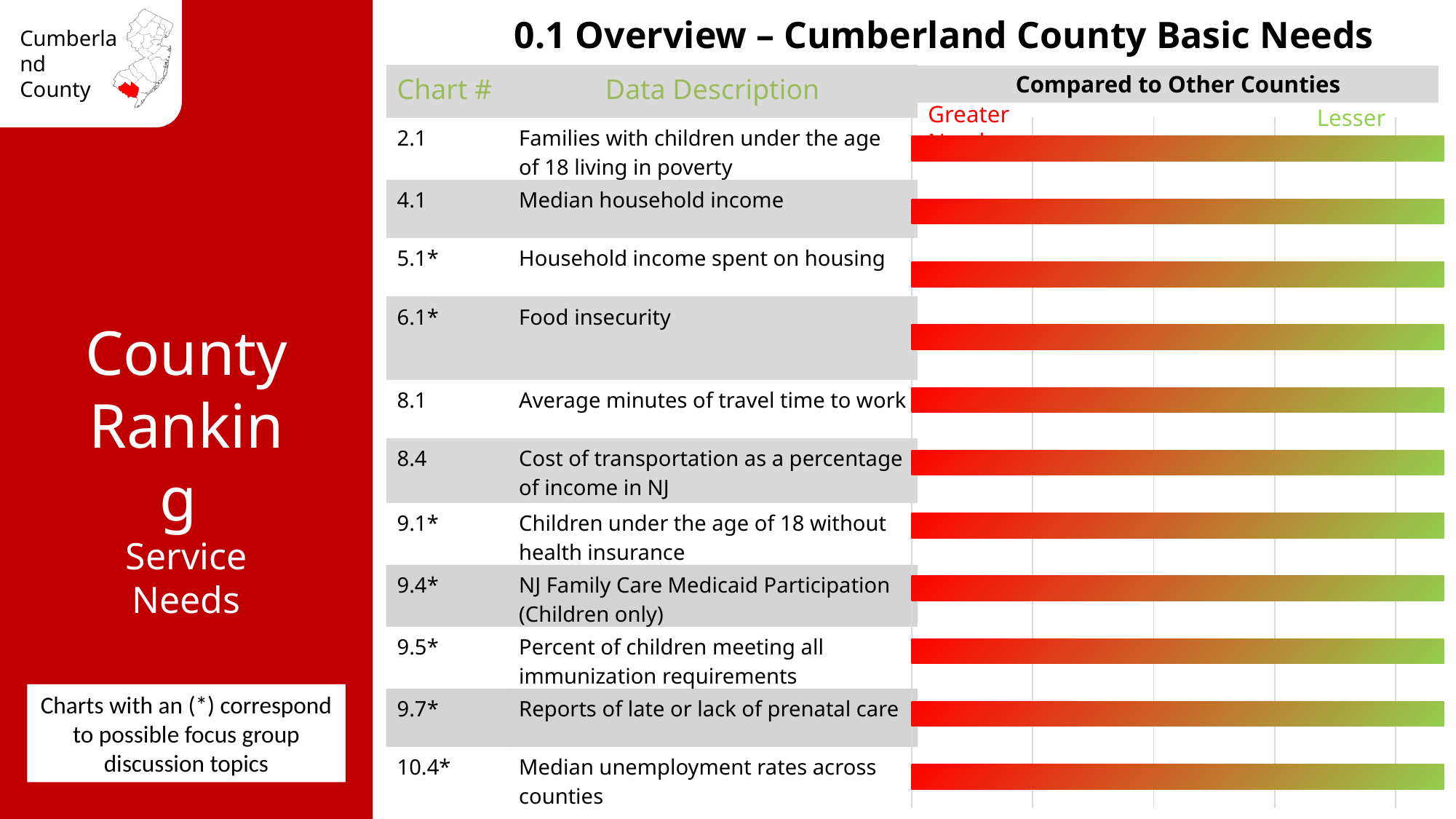
Which data description corresponds to chart number 8.1? Average minutes of travel time to work How many rows in the chart are marked with an asterisk (*)? 7 Which chart number corresponds to the bar for 'Food insecurity'? 6.1* What label appears at the right end of the chart's scale, opposite 'Greater Need'? Lesser What kind of chart is used in the 'Compared to Other Counties' column? bar chart What is the title of the slide containing the chart? 0.1 Overview – Cumberland County Basic Needs How many horizontal bars are plotted in the 'Compared to Other Counties' chart? 11